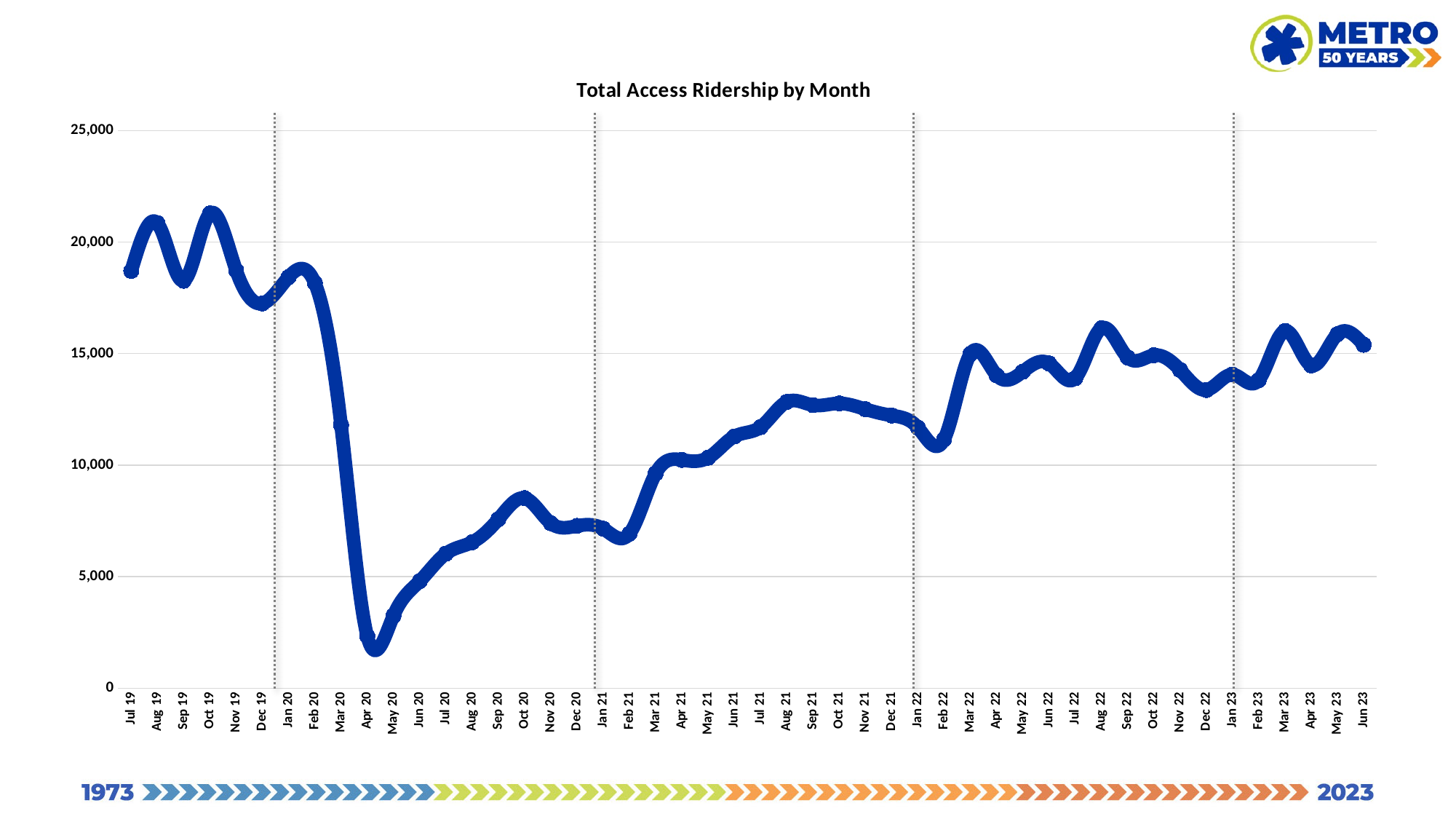
Is the value for Oct 19 greater or less than 20,000? greater Is the value for Aug 22 greater or less than 15,000? greater Does ridership rise or fall between Jan 20 and Apr 20? fall What is the title of the chart? Total Access Ridership by Month In which month is Total Access Ridership lowest? Apr 20 Which month has higher ridership, Jan 21 or Aug 21? Aug 21 In which month is Total Access Ridership highest? Oct 19 What kind of chart is shown on the slide? line chart How many lines are plotted on the chart? 1 Is the value for Apr 20 greater or less than 5,000? less How many months are plotted along the x axis of the chart? 48